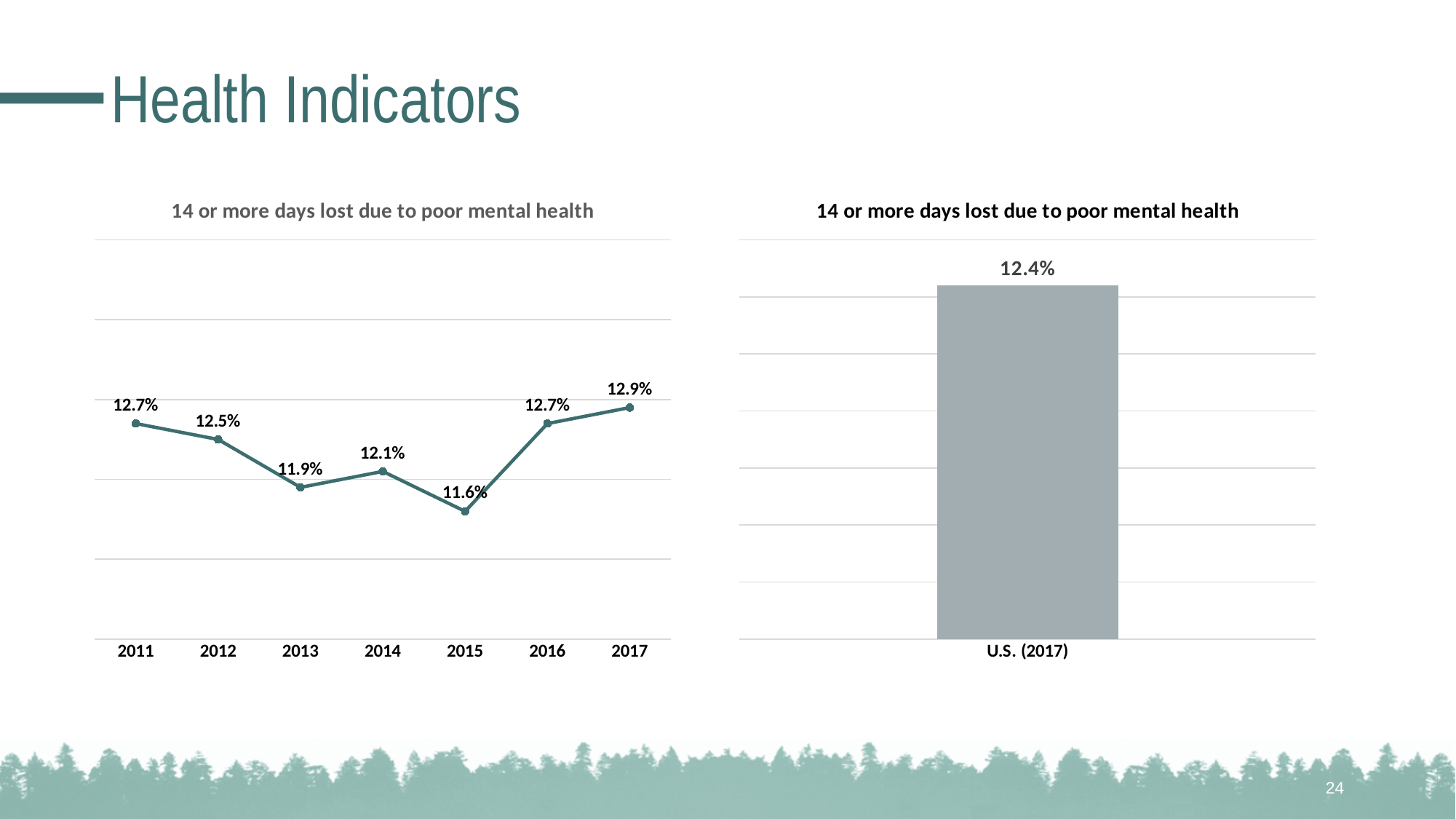
In the left chart, what is the difference between the 2017 value and the 2015 value? 1.3% In the right chart, what is the value for U.S. (2017)? 12.4% In the left chart, what is the value for 2017? 12.9% In the left chart, which is larger, the value for 2014 or the value for 2012? 2012 In the left chart, which year has the lowest value? 2015 In the left chart, what is the value for 2013? 11.9% What kind of chart is the right chart? bar chart In the left chart, what is the value for 2015? 11.6% In the left chart, which year has the highest value? 2017 What kind of chart is the left chart? line chart How many years are plotted in the left chart? 7 In the left chart, do the values rise or fall from 2015 to 2017? rise